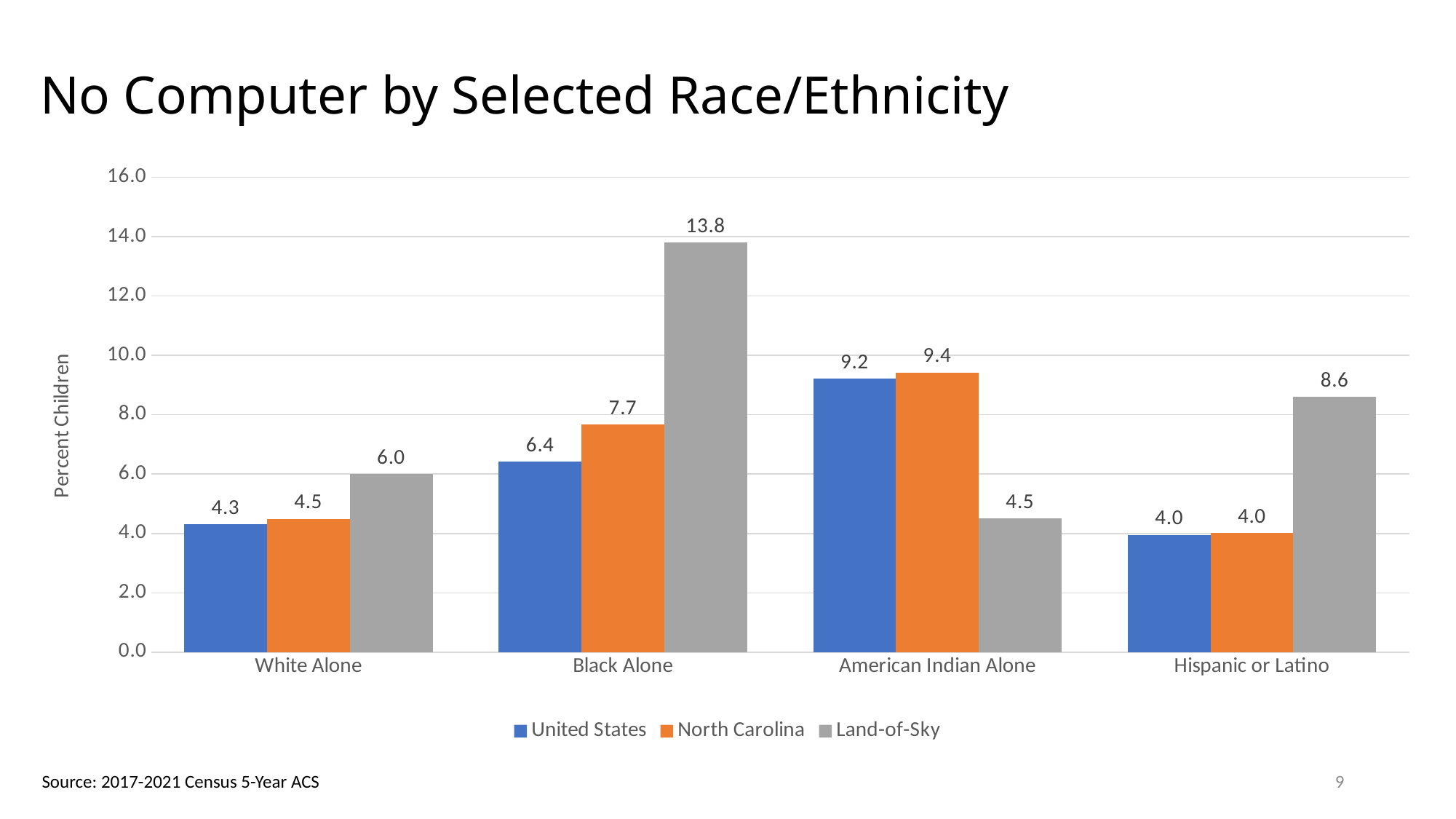
What kind of chart is shown on the slide? Bar chart What is the difference between the Land-of-Sky and North Carolina values for Black Alone? 6.1 How many race/ethnicity categories are shown on the x axis? 4 What is the Land-of-Sky value for Black Alone? 13.8 Which category has the highest Land-of-Sky value? Black Alone What is the label on the vertical axis? Percent Children Is the Land-of-Sky value for Hispanic or Latino greater or less than 8.0? greater What is the North Carolina value for White Alone? 4.5 For American Indian Alone, which is larger: the North Carolina value or the Land-of-Sky value? North Carolina How many series does the legend list? 3 Which category has the lowest United States value? Hispanic or Latino What is the United States value for American Indian Alone? 9.2